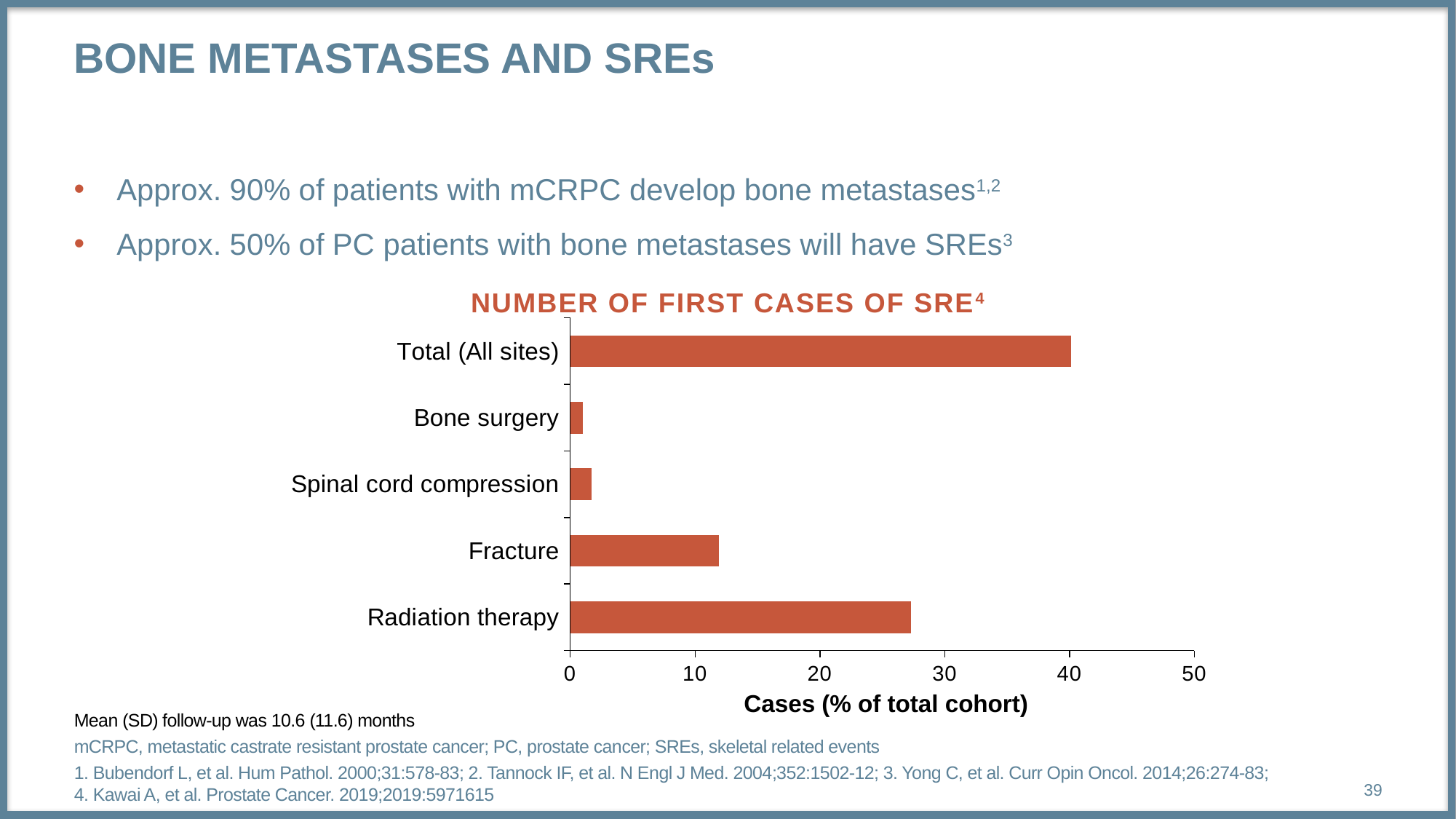
Is the value for Fracture greater or less than 10? greater Is the value for Total (All sites) greater or less than 30? greater Is the value for Spinal cord compression greater or less than 10? less What kind of chart is shown on the slide? bar chart Which has a larger value, Fracture or Radiation therapy? Radiation therapy What is the label of the horizontal axis of the chart? Cases (% of total cohort) Which category has the highest value in the chart? Total (All sites) Which has a larger value, Spinal cord compression or Fracture? Fracture Which category has the lowest value in the chart? Bone surgery What is the title of the chart? NUMBER OF FIRST CASES OF SRE How many categories are plotted in the chart? 5